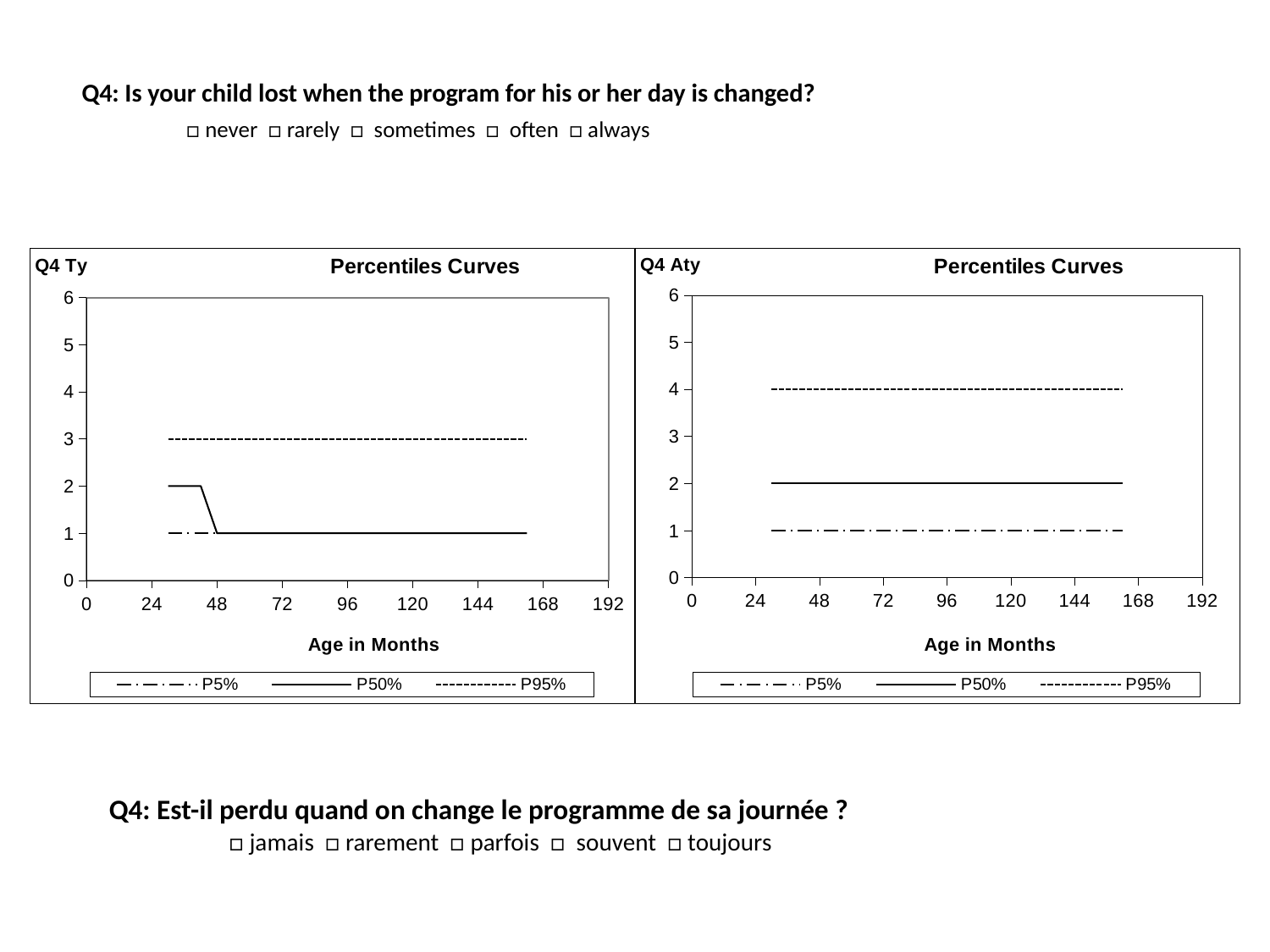
In the right chart (Q4 Aty), at what value does the P5% line stay across all ages? 1 In the left chart (Q4 Ty), at what value does the P95% line stay across all ages? 3 Which chart has the higher P95% line, the left chart (Q4 Ty) or the right chart (Q4 Aty)? the right chart (Q4 Aty) In the left chart (Q4 Ty), what kind of chart is shown? line chart In the left chart (Q4 Ty), what is the value of the P50% line at 120 months? 1 In the right chart (Q4 Aty), at what value does the P95% line stay across all ages? 4 In the right chart (Q4 Aty), how many series does the legend list? 3 In the left chart (Q4 Ty), which series is highest? P95% In the right chart (Q4 Aty), at what value does the P50% line stay across all ages? 2 In the left chart (Q4 Ty), does the P50% line rise, fall, or stay flat as age increases from 24 to 72 months? fall In the right chart (Q4 Aty), what is the difference between the P95% and P5% values at 96 months? 3 What is the x-axis title of the right chart (Q4 Aty)? Age in Months